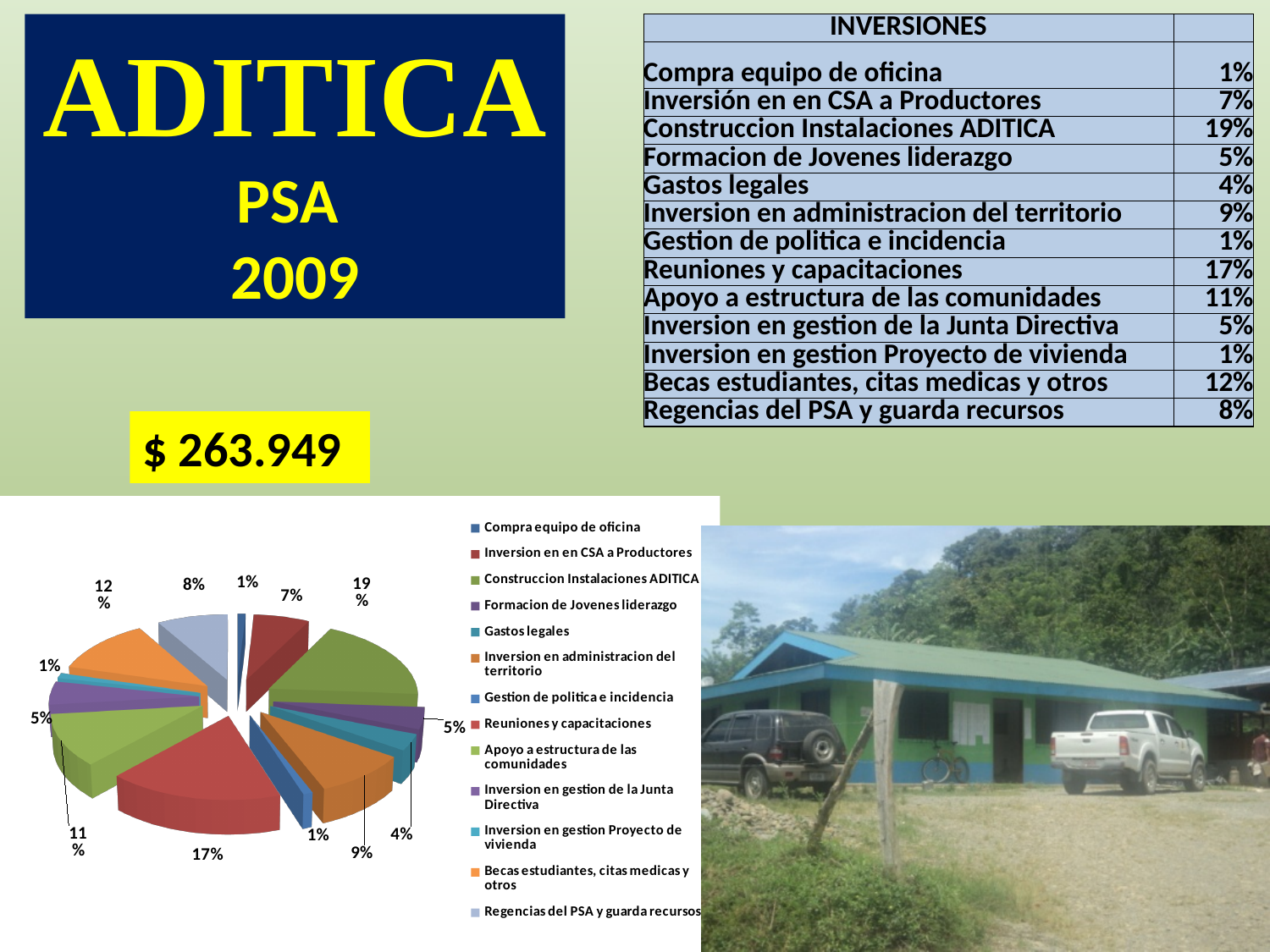
What is the value for Becas estudiantes, citas medicas y otros in the pie chart? 12% Which is larger in the pie chart: Reuniones y capacitaciones or Becas estudiantes, citas medicas y otros? Reuniones y capacitaciones What is the difference between the shares for Construccion Instalaciones ADITICA and Reuniones y capacitaciones? 2% What is the value for Regencias del PSA y guarda recursos in the pie chart? 8% What share of the pie does Construccion Instalaciones ADITICA represent? 19% What is the value for Inversion en administracion del territorio in the pie chart? 9% What is the value for Apoyo a estructura de las comunidades in the pie chart? 11% Which category has the largest slice of the pie chart? Construccion Instalaciones ADITICA What is the value for Reuniones y capacitaciones in the pie chart? 17% What kind of chart is shown on the slide? pie chart How many categories does the pie chart's legend list? 13 What is the total amount shown in the yellow box on the slide? $ 263.949